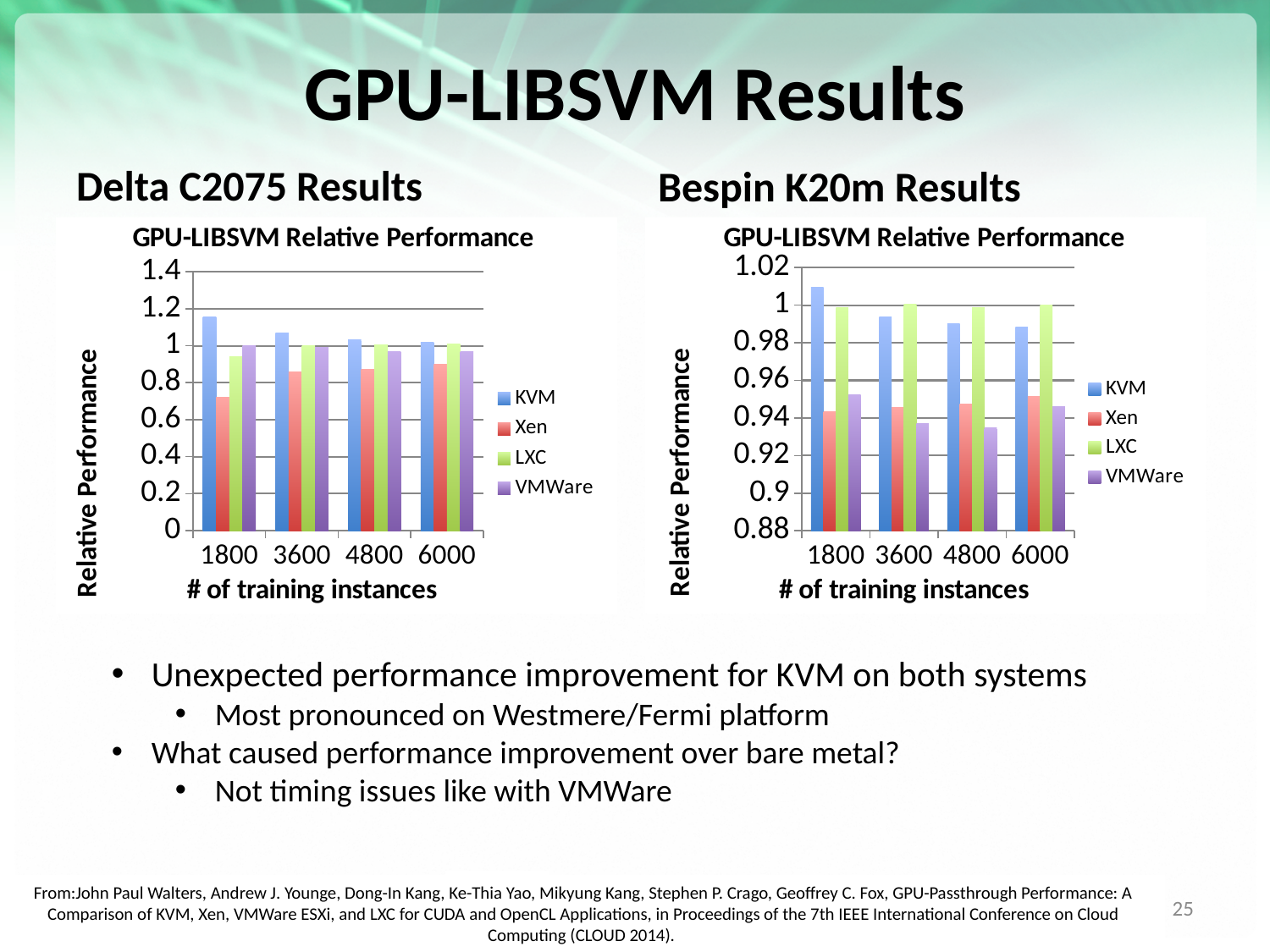
How many training-instance categories are shown on the x axis of the Delta C2075 Results chart? 4 On the Bespin K20m Results chart, which series has the highest value at 1800 training instances? KVM What kind of chart is the Delta C2075 Results chart? bar chart On the Delta C2075 Results chart, do the Xen values rise or fall as the number of training instances increases? rise On the Delta C2075 Results chart, is the value for Xen at 1800 training instances greater or less than 0.8? less On the Bespin K20m Results chart, is the value for VMWare at 4800 training instances greater or less than 0.94? less On the Delta C2075 Results chart, is the value for KVM at 1800 training instances greater or less than 1? greater On the Delta C2075 Results chart, do the KVM values rise or fall as the number of training instances increases? fall On the Bespin K20m Results chart, which is larger at 3600 training instances, Xen or VMWare? Xen On the Delta C2075 Results chart, which series has the lowest value at 1800 training instances? Xen How many series does the legend of the Bespin K20m Results chart list? 4